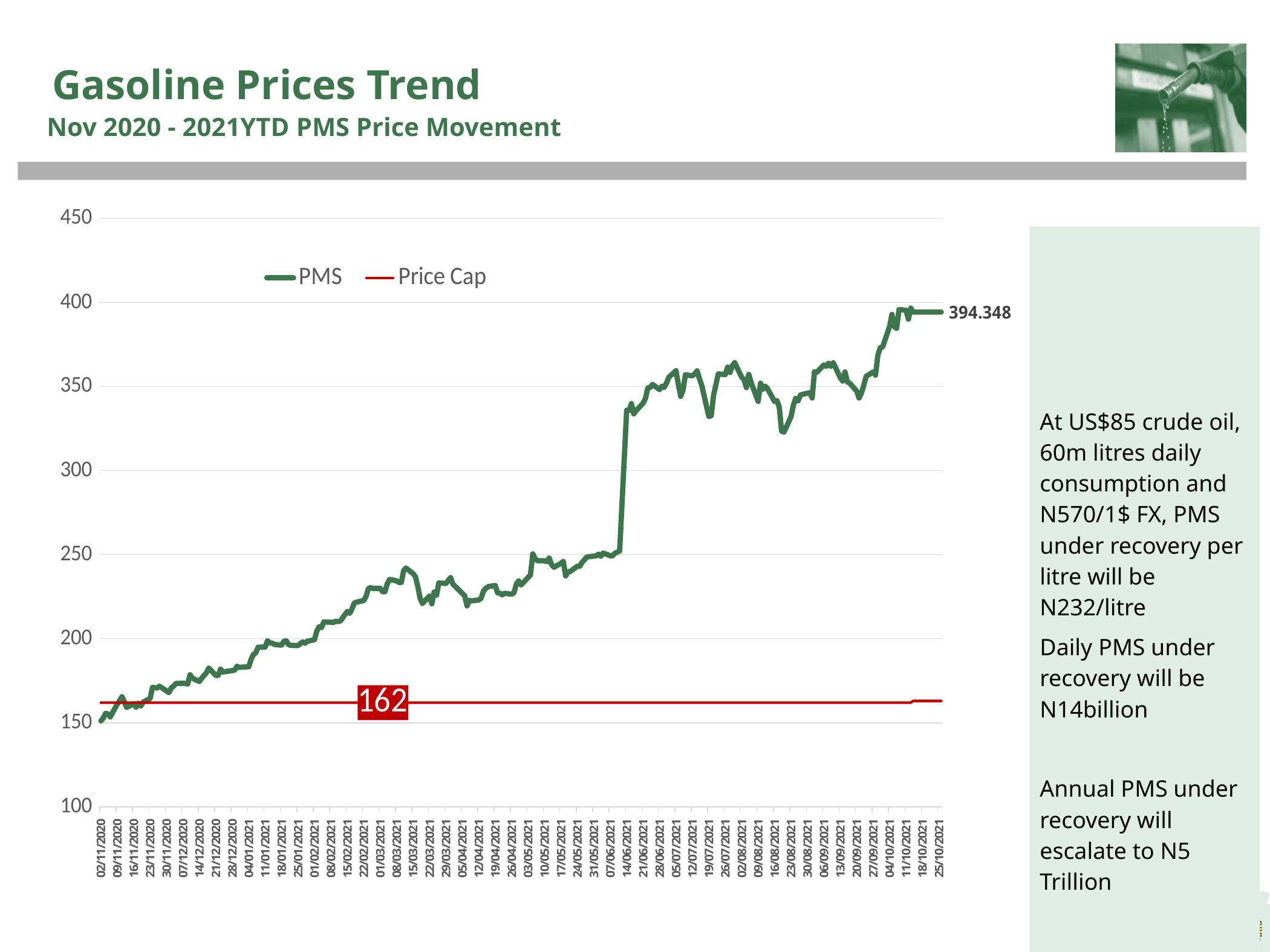
Is the PMS value on 02/11/2020 greater or less than 200? less What is the PMS value labelled at the end of the line (25/10/2021)? 394.348 What value is labelled on the Price Cap line? 162 How many series does the chart legend list? 2 What kind of chart is shown on the slide? line chart Is the PMS value on 28/06/2021 greater or less than 300? greater What colour is the PMS line in the chart? green What is the subtitle of the chart shown under the slide title? Nov 2020 - 2021YTD PMS Price Movement At the end of the period, which is larger: the PMS value or the Price Cap? PMS Is the PMS value on 04/01/2021 greater or less than 250? less What is the difference between the final PMS value (394.348) and the Price Cap (162)? 232.348 Does the PMS line generally rise or fall from November 2020 to October 2021? rise